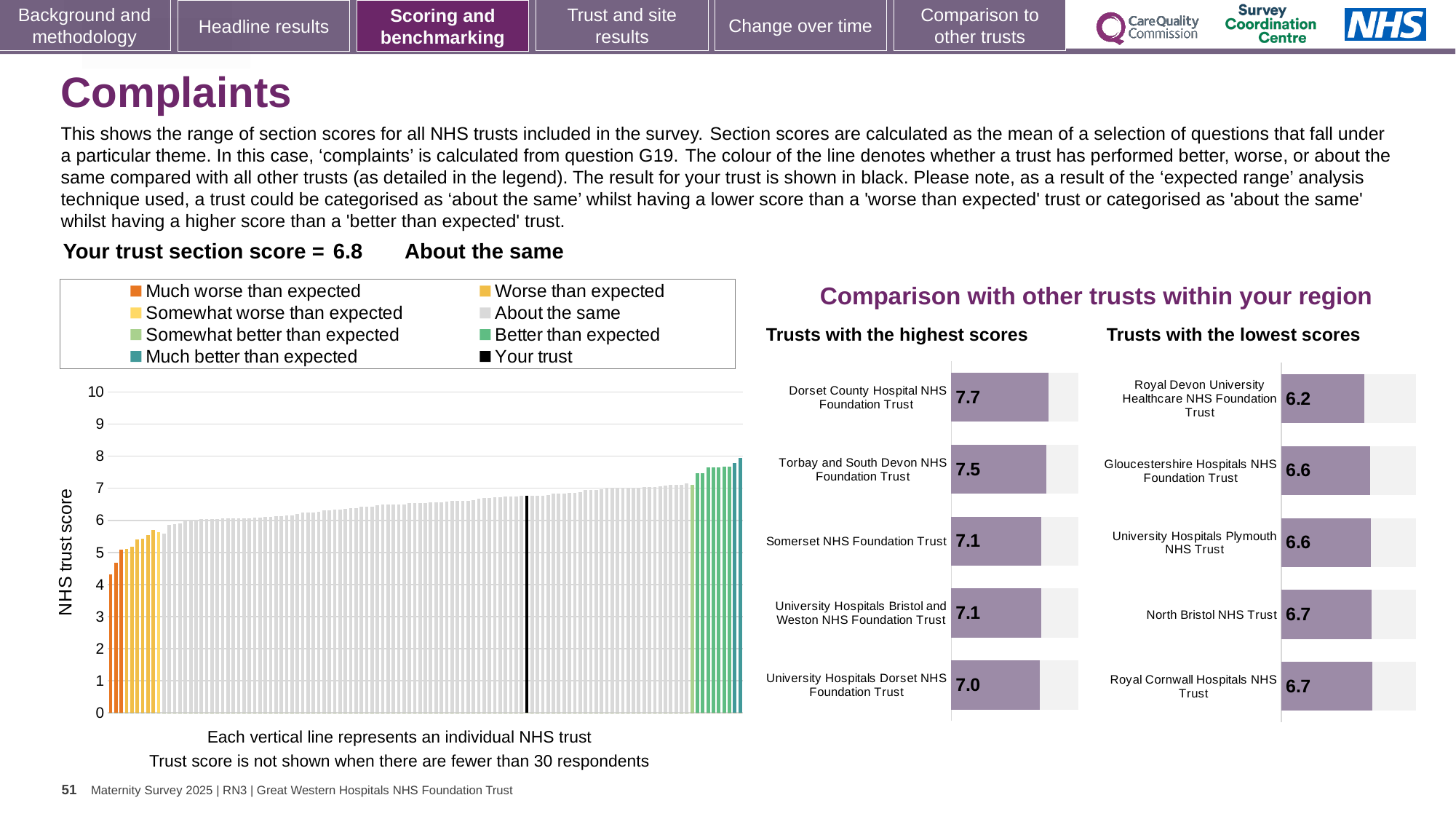
In the 'Trusts with the highest scores' chart, what is the score for Dorset County Hospital NHS Foundation Trust? 7.7 In the 'Trusts with the highest scores' chart, which trust has the highest score? Dorset County Hospital NHS Foundation Trust In the 'Trusts with the lowest scores' chart, what is the score for North Bristol NHS Trust? 6.7 In the 'Trusts with the lowest scores' chart, which trust has the lowest score? Royal Devon University Healthcare NHS Foundation Trust In the 'Trusts with the lowest scores' chart, how many trusts are shown? 5 In the 'Trusts with the highest scores' chart, what is the difference between the scores of Dorset County Hospital NHS Foundation Trust and University Hospitals Dorset NHS Foundation Trust? 0.7 In the 'NHS trust score' chart on the left, do the bar values rise or fall from left to right? Rise In the 'Trusts with the highest scores' chart, what is the score for University Hospitals Dorset NHS Foundation Trust? 7.0 In the 'Trusts with the highest scores' chart, which has the larger score: Torbay and South Devon NHS Foundation Trust or Somerset NHS Foundation Trust? Torbay and South Devon NHS Foundation Trust How many entries does the legend above the 'NHS trust score' chart list? 8 What kind of chart is the large 'NHS trust score' chart on the left of the slide? Bar chart In the 'Trusts with the lowest scores' chart, what is the score for Royal Devon University Healthcare NHS Foundation Trust? 6.2